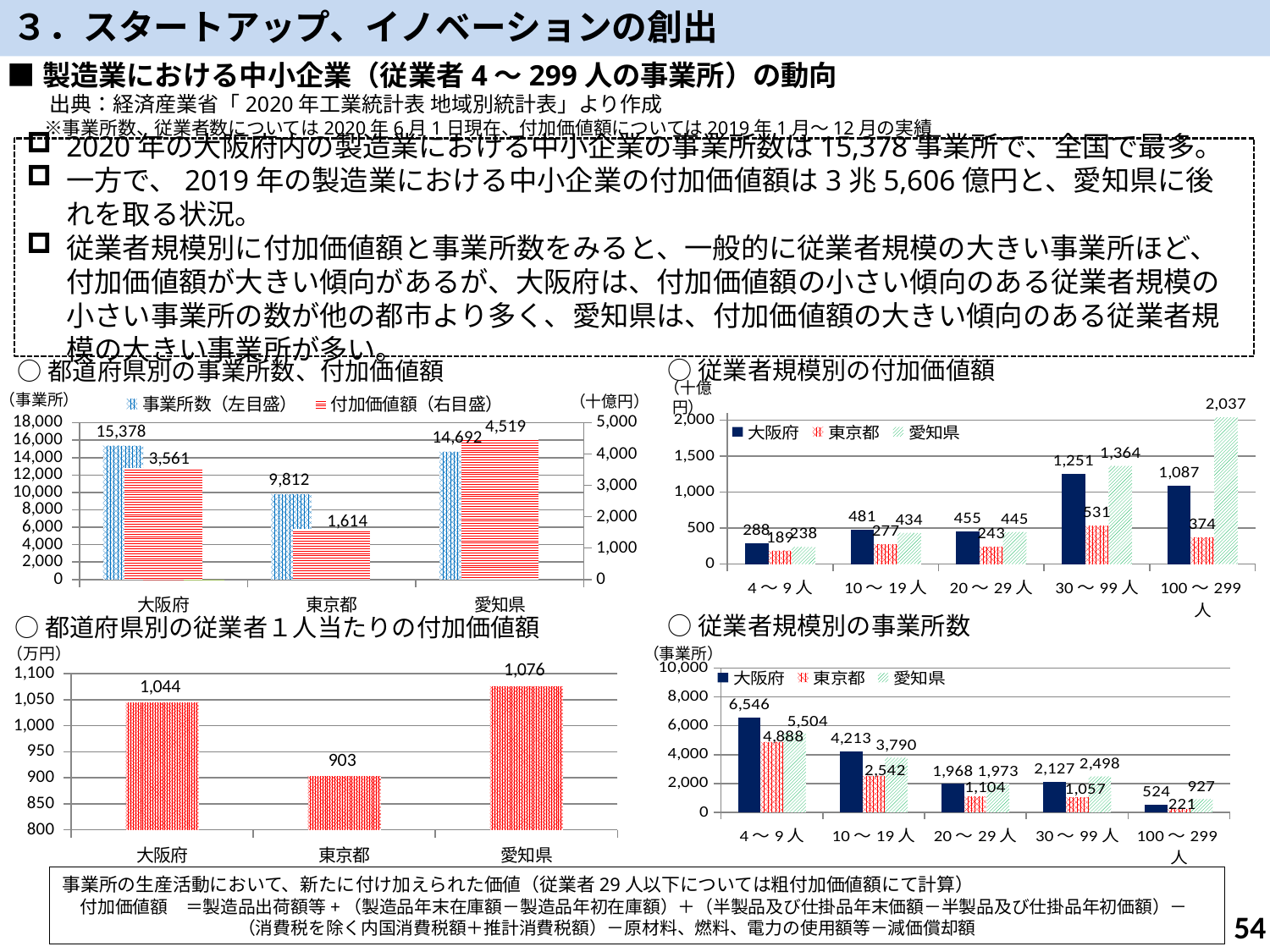
In the chart titled 従業者規模別の付加価値額, what is the value for 愛知県 in the 100～299人 category? 2,037 In the chart titled 従業者規模別の事業所数, how many employee-size categories are shown on the x axis? 5 In the chart titled 都道府県別の事業所数、付加価値額, what is the 付加価値額 value for 愛知県? 4,519 In the chart titled 都道府県別の事業所数、付加価値額, which prefecture has the lowest 付加価値額? 東京都 In the chart titled 従業者規模別の付加価値額, which is larger in the 30～99人 category, 大阪府 or 愛知県? 愛知県 What kind of chart is the one titled 従業者規模別の事業所数? Bar chart In the chart titled 都道府県別の従業者1人当たりの付加価値額, what is the value for 東京都? 903 In the chart titled 従業者規模別の事業所数, what is the value for 大阪府 in the 4～9人 category? 6,546 In the chart titled 都道府県別の従業者1人当たりの付加価値額, which prefecture has the highest value? 愛知県 In the chart titled 従業者規模別の付加価値額, how many series does the legend list? 3 In the chart titled 都道府県別の従業者1人当たりの付加価値額, what is the difference between the values for 愛知県 and 大阪府? 32 In the chart titled 都道府県別の事業所数、付加価値額, what is the 事業所数 value for 大阪府? 15,378